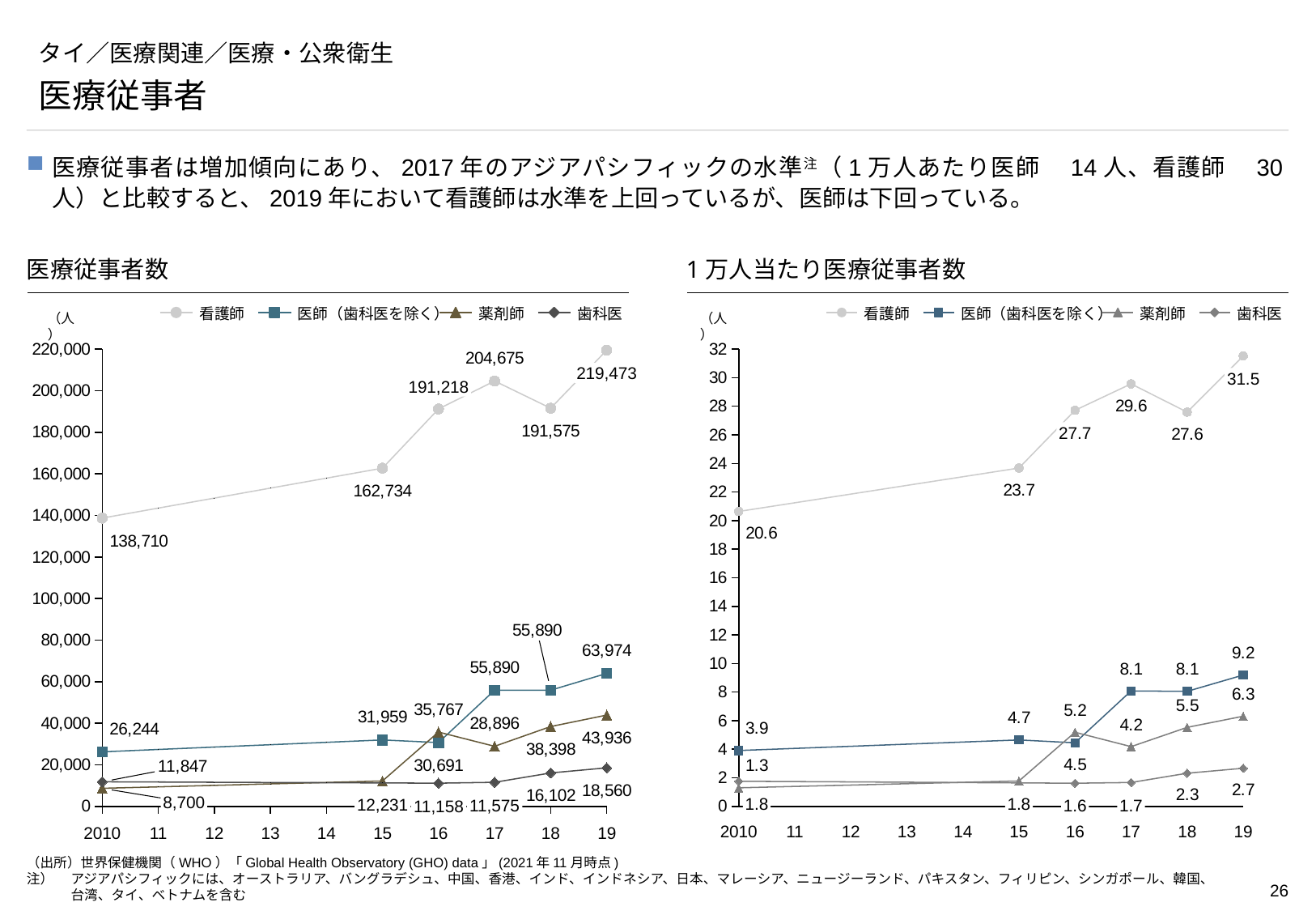
In the right chart (1万人当たり医療従事者数), what is the value for 医師（歯科医を除く） in 2019? 9.2 In the right chart (1万人当たり医療従事者数), what is the difference between the 医師（歯科医を除く） values in 2019 and 2010? 5.3 In the left chart (医療従事者数), what is the value for 医師（歯科医を除く） in 2010? 26,244 In the left chart (医療従事者数), what is the value for 薬剤師 in 2019? 43,936 In the right chart (1万人当たり医療従事者数), is the 看護師 value in 2019 greater or less than 30? greater In the right chart (1万人当たり医療従事者数), which is larger in 2019: 薬剤師 or 歯科医? 薬剤師 In the left chart (医療従事者数), what is the difference between the 看護師 values in 2019 and 2010? 80,763 In the right chart (1万人当たり医療従事者数), what is the value for 看護師 in 2017? 29.6 In the left chart (医療従事者数), what is the value for 看護師 in 2019? 219,473 What kind of chart is the left chart (医療従事者数)? line chart In the left chart (医療従事者数), in which year is the 看護師 value highest? 2019 In the left chart (医療従事者数), how many series does the legend list? 4